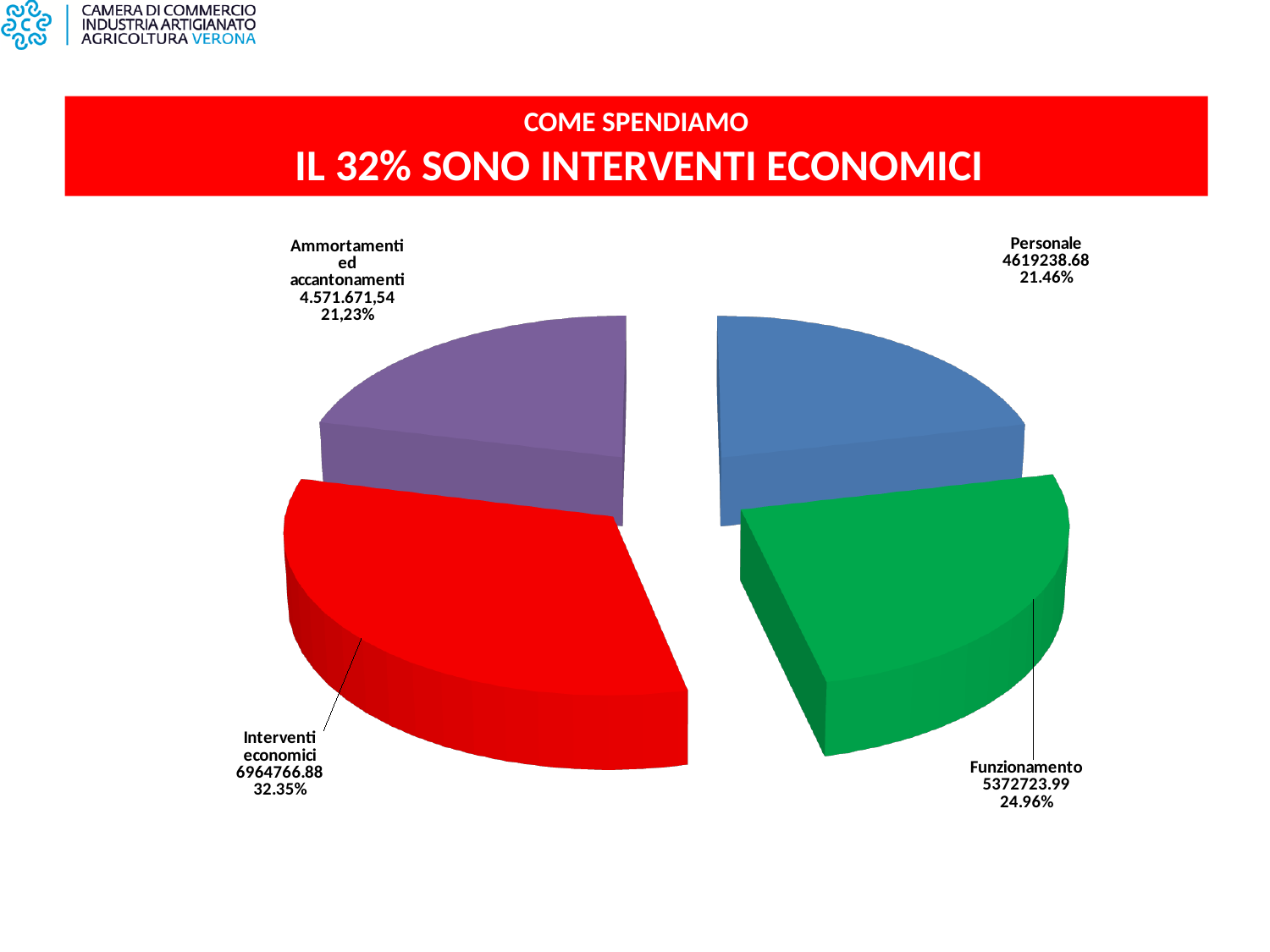
Which is larger, the value for Funzionamento or the value for Personale? Funzionamento What type of chart is shown on the slide? Pie chart How many slices does the pie chart have? 4 What is the value shown for Funzionamento? 5372723.99 What percentage share does the Interventi economici slice represent? 32.35% Which category has the smallest share of the pie? Ammortamenti ed accantonamenti What is the difference in percentage points between the Interventi economici share and the Funzionamento share? 7.39 What colour is the Interventi economici slice? Red What is the value shown for Ammortamenti ed accantonamenti? 4.571.671,54 Which category has the largest share of the pie? Interventi economici What percentage share is shown for Funzionamento? 24.96% What is the value shown for Personale? 4619238.68